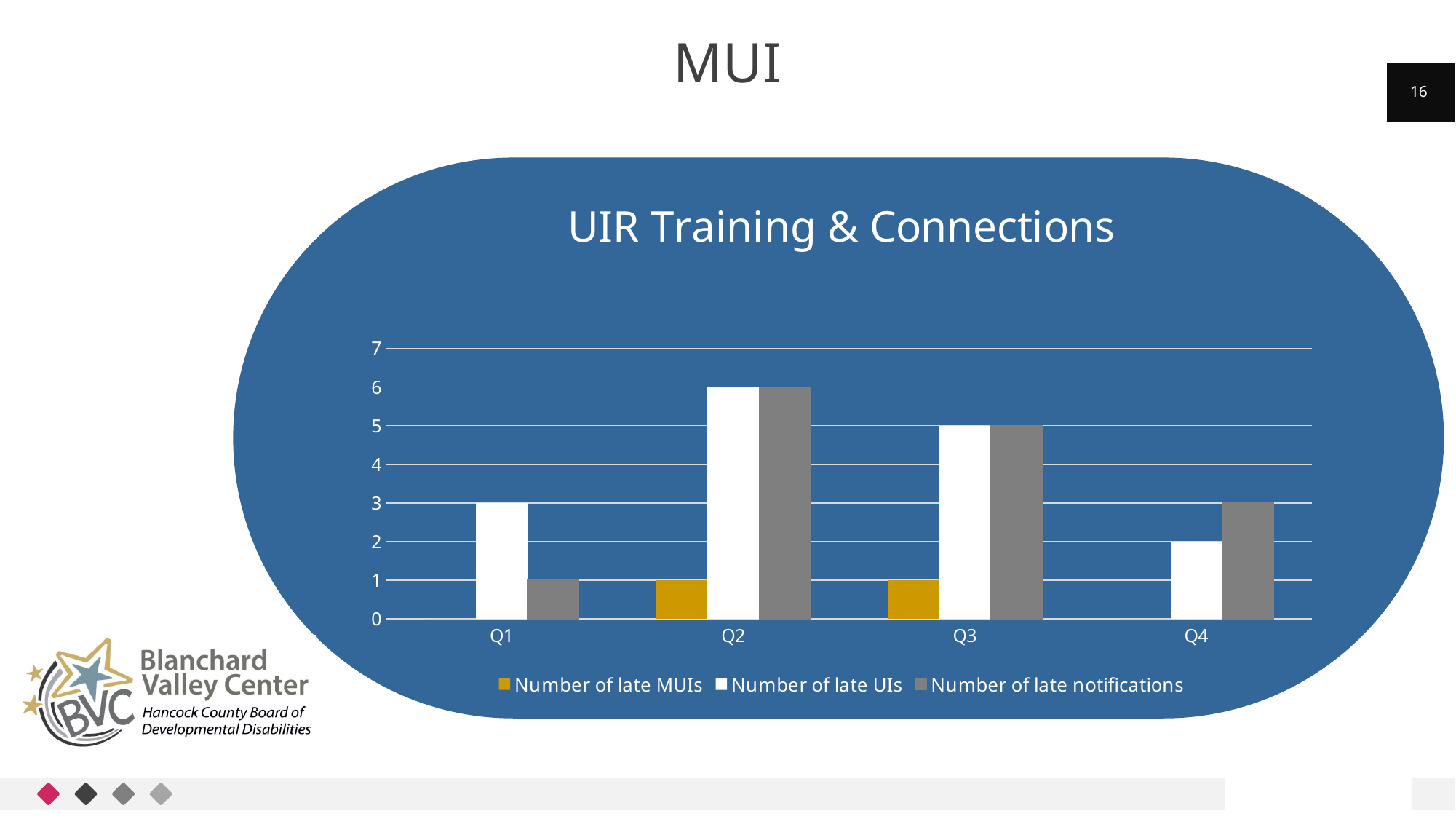
Does the number of late UIs rise or fall from Q2 to Q4? fall In which quarter is the number of late notifications lowest? Q1 What is the number of late MUIs in Q3? 1 What is the difference between the number of late UIs and the number of late notifications in Q1? 2 How many quarters are shown on the x axis? 4 In Q4, which is larger: the number of late UIs or the number of late notifications? Number of late notifications What is the number of late UIs in Q2? 6 What is the title of the chart? UIR Training & Connections What type of chart is shown on the slide? bar chart In which quarter is the number of late UIs highest? Q2 How many series does the legend list? 3 What is the number of late notifications in Q4? 3